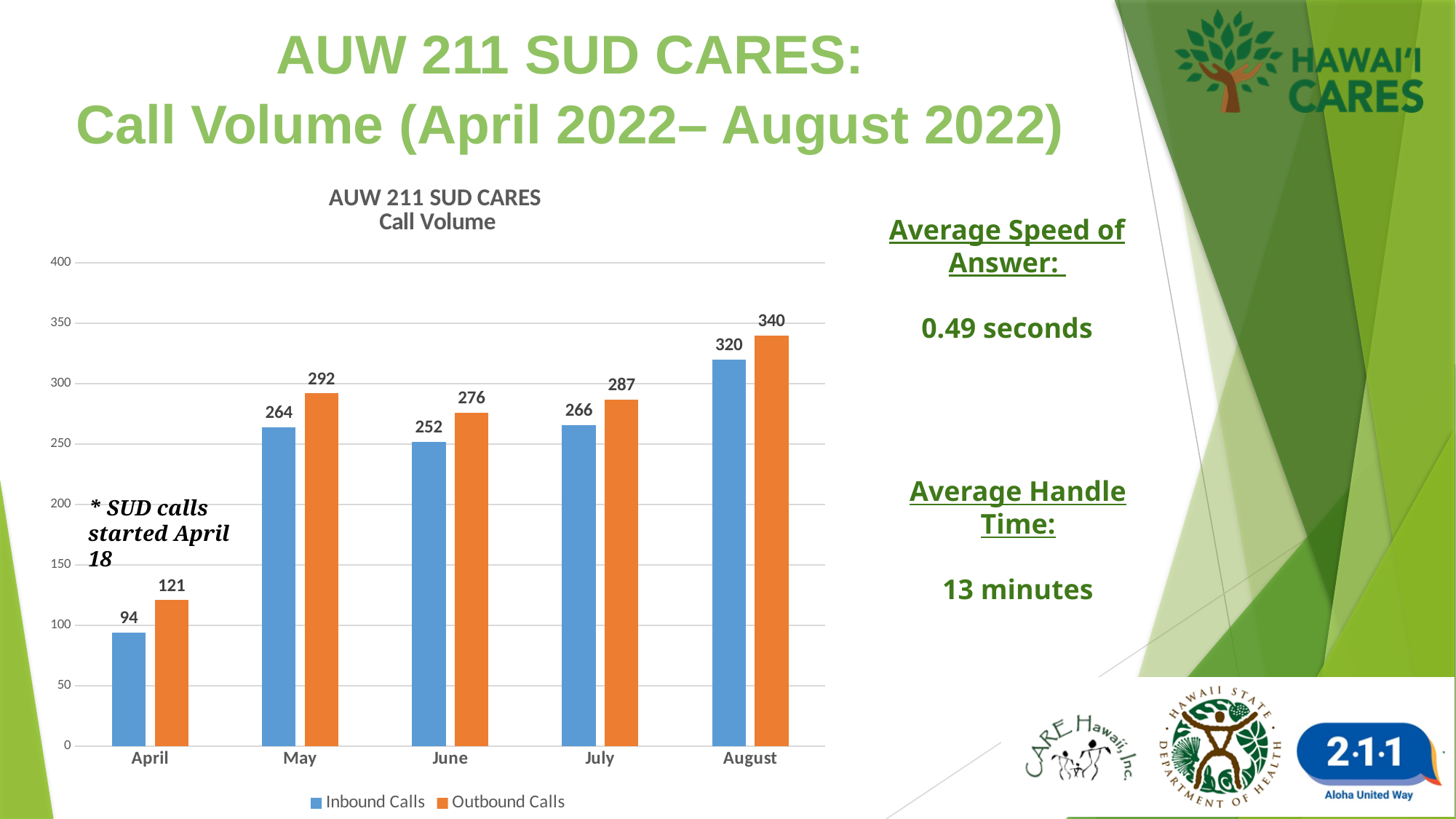
What is the number of Outbound Calls in April? 121 What is the number of Inbound Calls in May? 264 How many months are shown on the x axis? 5 What is the difference between Outbound Calls and Inbound Calls in June? 24 How many series does the legend list? 2 What is the title of the chart? AUW 211 SUD CARES Call Volume Which month has the highest number of Inbound Calls? August Which month has the lowest number of Outbound Calls? April Is the value for Outbound Calls in July greater or less than 250? greater What is the number of Outbound Calls in August? 340 What kind of chart is shown on the slide? Bar chart